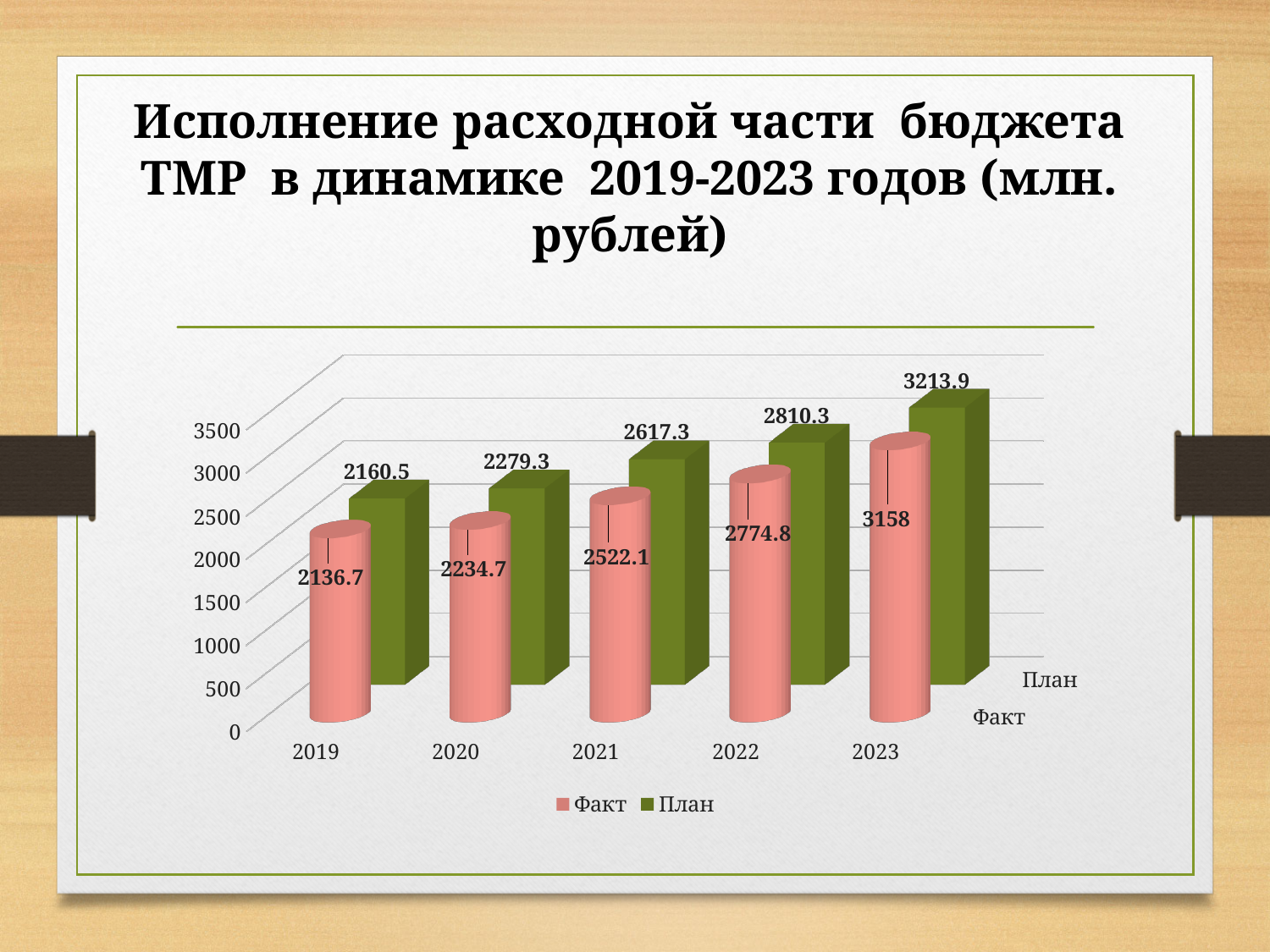
What is the План value for 2020? 2279.3 How many years are shown on the x axis? 5 Which year has the highest Факт value? 2023 Which year has the lowest План value? 2019 Do the Факт values rise or fall from 2019 to 2023? Rise What is the План value for 2023? 3213.9 What is the difference between the План and Факт values for 2022? 35.5 Which is larger for 2020, the Факт value or the План value? План What kind of chart is shown on the slide? Bar chart How many series does the legend list? 2 What is the Факт value for 2019? 2136.7 What is the Факт value for 2021? 2522.1